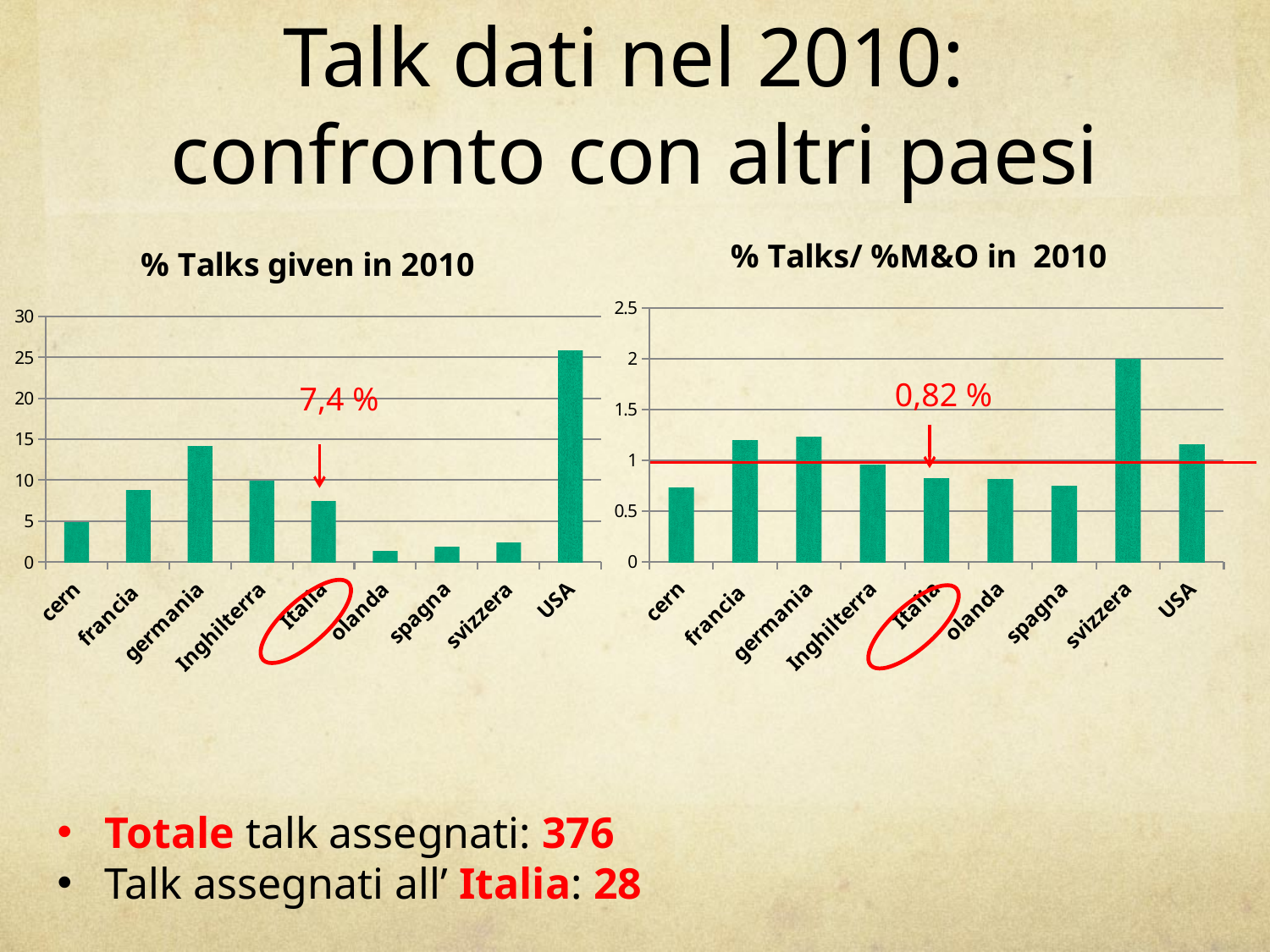
What kind of chart is the left chart titled "% Talks given in 2010"? bar chart In the left chart "% Talks given in 2010", how many countries/categories are shown on the x axis? 9 In the right chart "% Talks/ %M&O in 2010", what value is annotated for Italia? 0,82 % In the right chart "% Talks/ %M&O in 2010", is the value for svizzera greater or less than 1.5? greater In the left chart "% Talks given in 2010", what value is annotated for Italia? 7,4 % In the left chart "% Talks given in 2010", which category has the highest value? USA In the right chart "% Talks/ %M&O in 2010", which category has the highest value? svizzera In the right chart "% Talks/ %M&O in 2010", which is larger, the value for francia or the value for cern? francia What is the title of the chart on the right side of the slide? % Talks/ %M&O in 2010 In the left chart "% Talks given in 2010", which is larger, the value for germania or the value for francia? germania In the left chart "% Talks given in 2010", is the value for USA greater or less than 20? greater In the left chart "% Talks given in 2010", is the value for germania greater or less than 10? greater